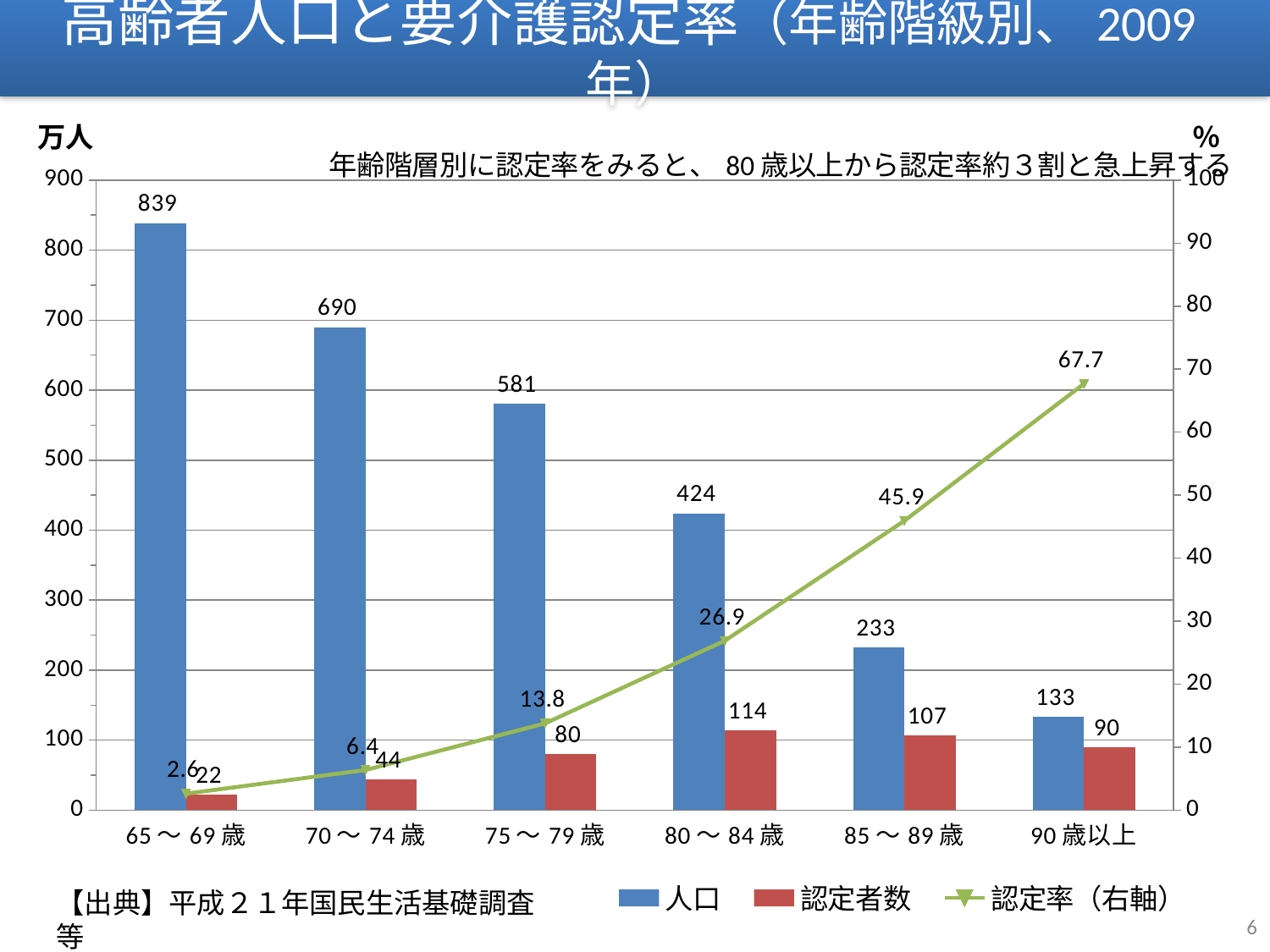
What is the 認定率 value for the 90歳以上 age group? 67.7 Which age group has the highest 認定者数? 80～84歳 What is the 人口 value for the 65～69歳 age group? 839 What kind of chart is shown on the slide? Combined bar and line chart Which series is plotted on the right axis according to the legend? 認定率（右軸） How many series does the legend list? 3 Which is larger, the 認定者数 for 85～89歳 or for 90歳以上? 85～89歳 What is the 認定者数 value for the 80～84歳 age group? 114 Which age group has the lowest 人口? 90歳以上 How many age groups are shown on the x axis? 6 Does the 認定率 line rise or fall as age increases along the x axis? Rises What is the difference in 人口 between the 65～69歳 and 70～74歳 age groups? 149